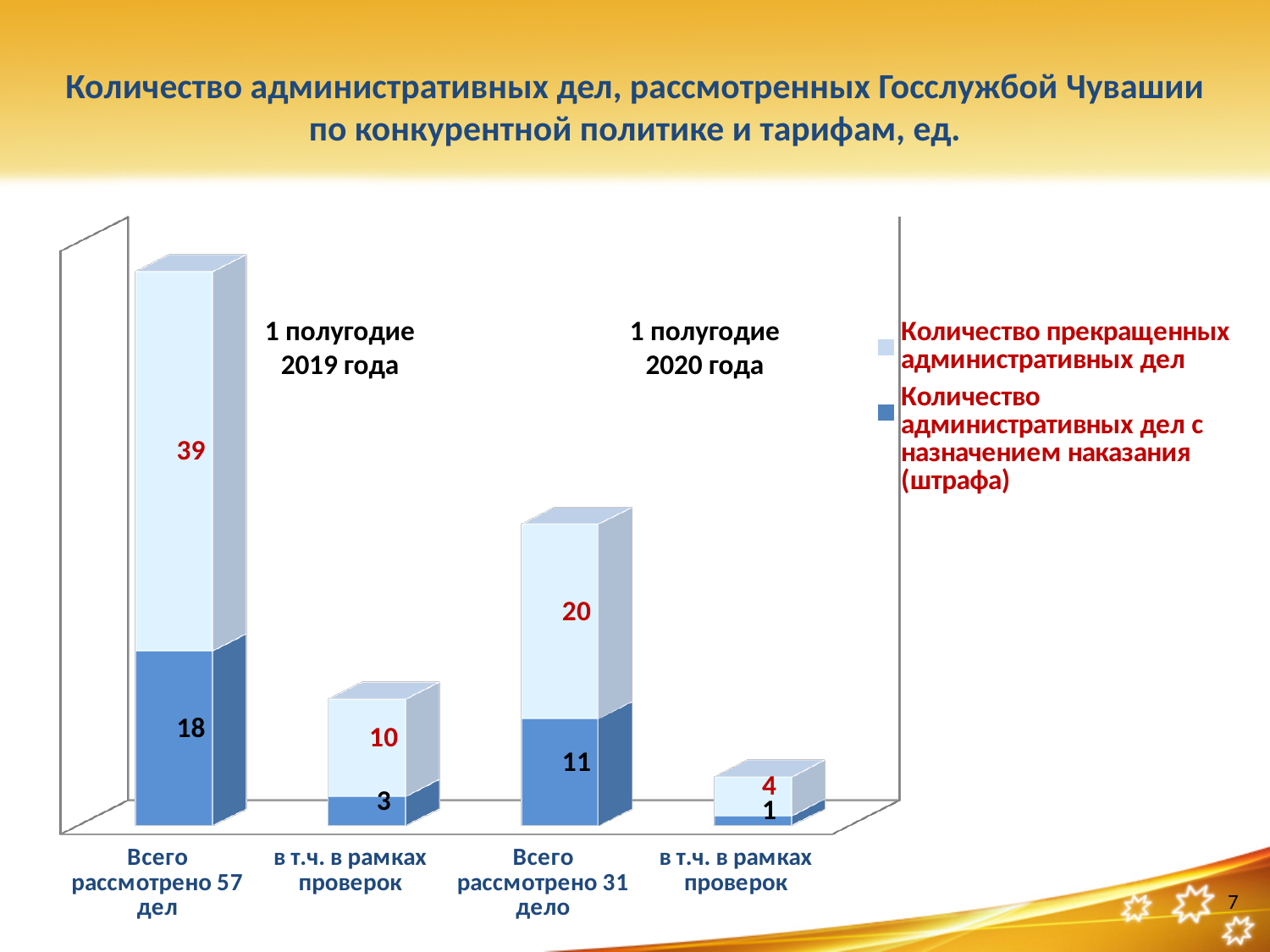
What is the value of 'Количество административных дел с назначением наказания (штрафа)' for the bar 'Всего рассмотрено 31 дело' (1 полугодие 2020 года)? 11 What is the difference between the 'Количество прекращенных административных дел' values for 'Всего рассмотрено 57 дел' and 'Всего рассмотрено 31 дело'? 19 What is the value of 'Количество прекращенных административных дел' for the bar 'Всего рассмотрено 57 дел' (1 полугодие 2019 года)? 39 What is the value of 'Количество административных дел с назначением наказания (штрафа)' for 'в т.ч. в рамках проверок' in 1 полугодие 2020 года? 1 Which is larger: 'Количество прекращенных административных дел' for 'в т.ч. в рамках проверок' in 1 полугодие 2019 года or in 1 полугодие 2020 года? 1 полугодие 2019 года Which bar has the highest value of 'Количество административных дел с назначением наказания (штрафа)'? Всего рассмотрено 57 дел How many series does the legend list? 2 What is the total of the stacked bar 'Всего рассмотрено 31 дело' (1 полугодие 2020 года)? 31 How many bars (categories) are plotted on the chart? 4 What is the value of 'Количество прекращенных административных дел' for 'в т.ч. в рамках проверок' in 1 полугодие 2019 года? 10 What kind of chart is shown on the slide? Stacked bar chart What is the total of the stacked bar 'в т.ч. в рамках проверок' for 1 полугодие 2019 года? 13